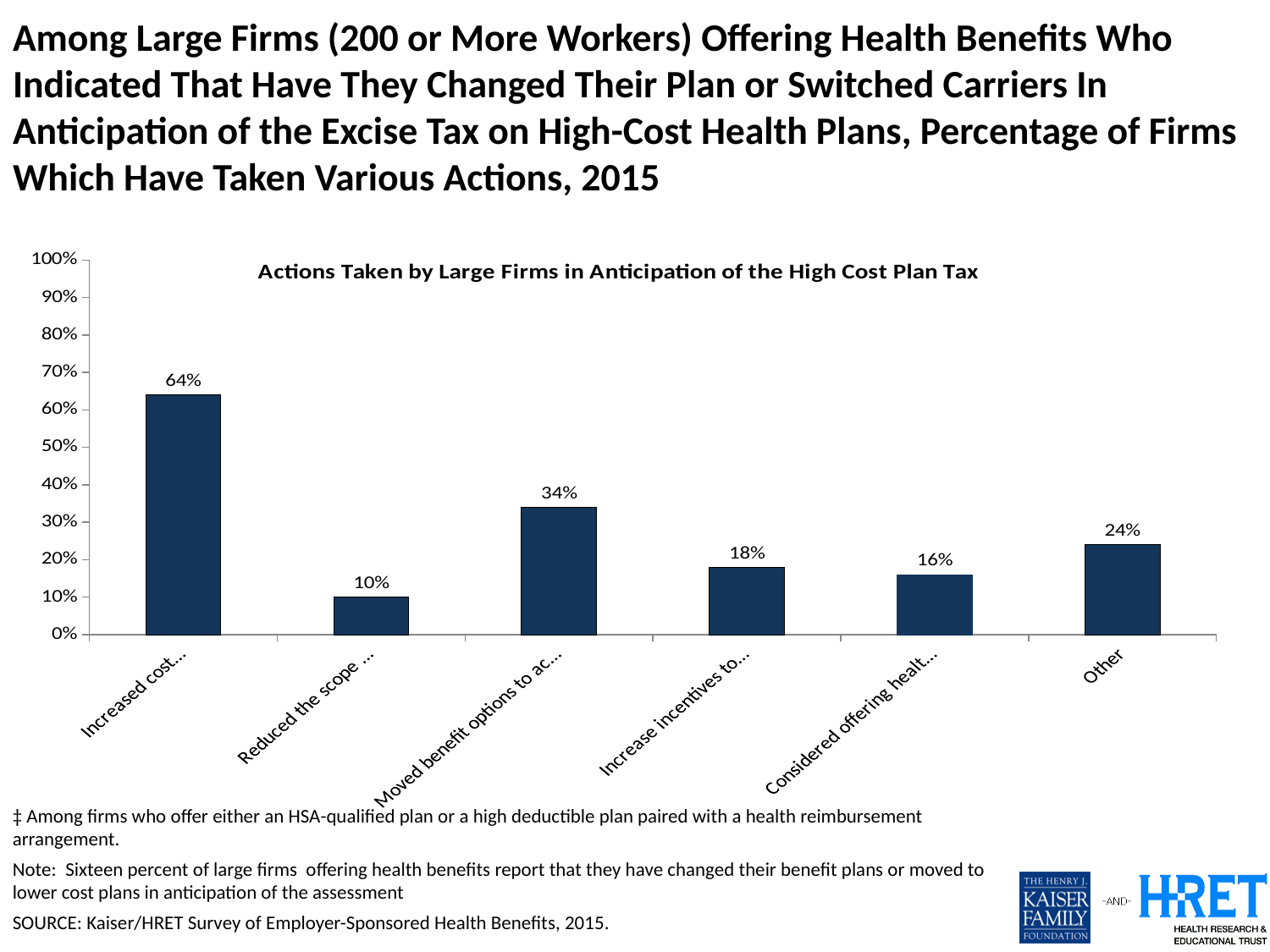
What kind of chart is shown on the slide? Bar chart How many bars are shown in the chart? 6 Which category has the highest value? Increased cost... What is the value of the bar labelled "Other"? 24% What is the title printed inside the chart area? Actions Taken by Large Firms in Anticipation of the High Cost Plan Tax Which category has the lowest value? Reduced the scope ... What is the value of the bar whose label begins "Reduced the scope"? 10% What is the difference between the bar beginning "Increased cost" and the bar beginning "Moved benefit options"? 30% What is the value of the bar whose label begins "Moved benefit options"? 34% Which is larger: the bar beginning "Increase incentives" or the bar beginning "Considered offering"? Increase incentives to... What is the value of the bar whose label begins "Increased cost"? 64% Is the value for "Other" greater or less than 20%? greater